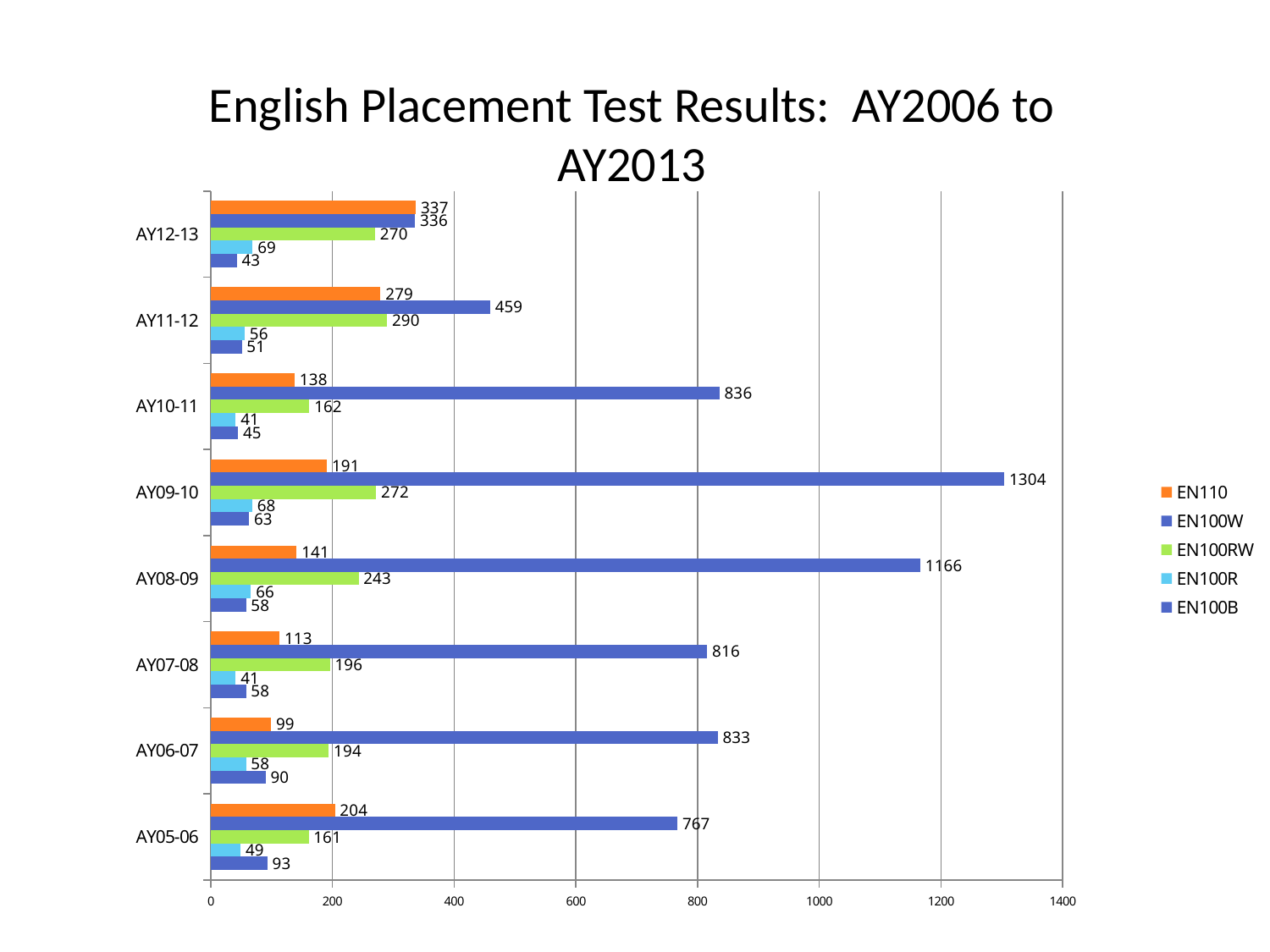
What is the EN100W value for AY09-10? 1304 How many series does the legend list? 5 What is the EN100B value for AY05-06? 93 What is the EN100RW value for AY11-12? 290 What type of chart is shown on the slide? bar chart What is the difference between the EN100W values for AY09-10 and AY08-09? 138 What is the title of the chart? English Placement Test Results: AY2006 to AY2013 In which academic year is the EN100W value highest? AY09-10 What is the EN110 value for AY12-13? 337 How many academic years are shown on the chart? 8 Which is larger for AY11-12, EN100W or EN110? EN100W In which academic year is the EN110 value lowest? AY06-07